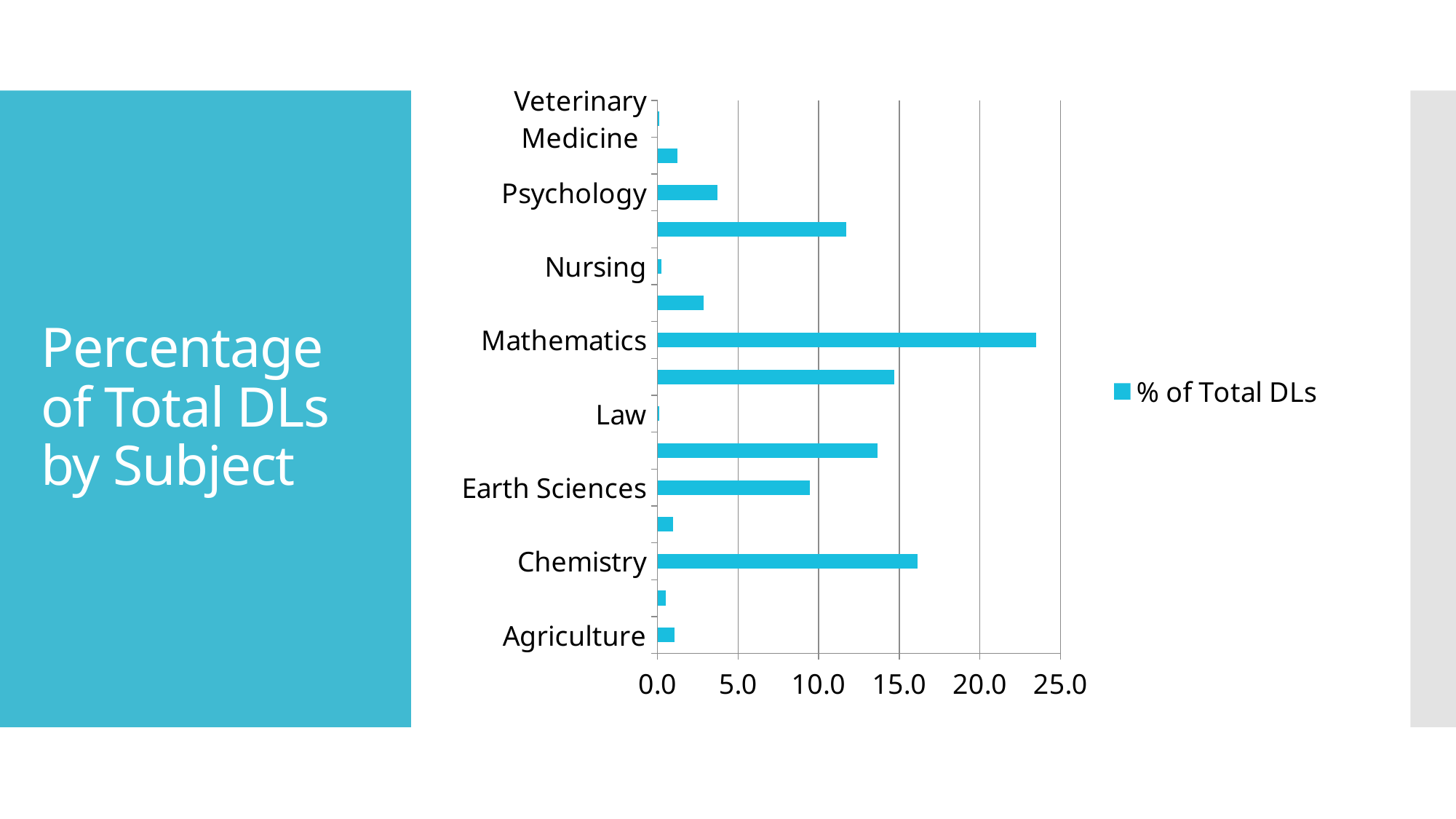
Is the value for Mathematics greater or less than 20.0? greater Which has a larger value, Psychology or Nursing? Psychology Which has a larger value, Mathematics or Chemistry? Mathematics What is the legend entry for the series in the chart? % of Total DLs What is the title shown on the slide for this chart? Percentage of Total DLs by Subject Is the value for Earth Sciences greater or less than 10.0? less Is the value for Chemistry greater or less than 15.0? greater Which labelled subject has the highest percentage of total DLs? Mathematics What kind of chart is shown on the slide? bar chart Which has a larger value, Chemistry or Earth Sciences? Chemistry How many series does the legend list? 1